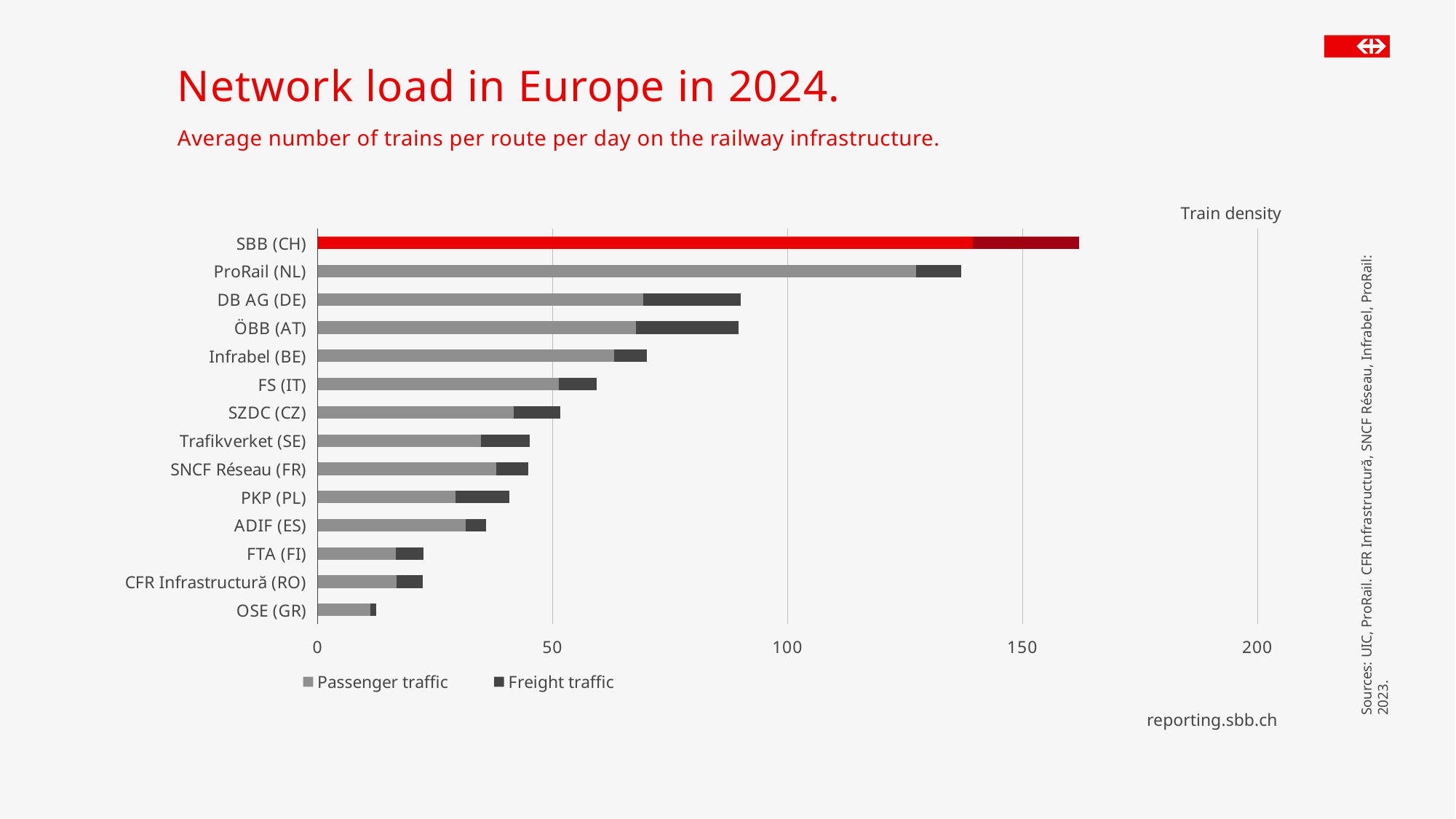
Which has the higher total train density, Infrabel (BE) or FS (IT)? Infrabel (BE) Is the total train density for DB AG (DE) greater or less than 100? less Which has the higher total train density, SBB (CH) or ProRail (NL)? SBB (CH) Which infrastructure manager has the highest train density? SBB (CH) How many series does the legend list? 2 How many railway infrastructure managers are listed on the chart? 14 Is the total train density for ProRail (NL) greater or less than 150? less Which infrastructure manager has the lowest train density? OSE (GR) What kind of chart is shown on the slide? bar chart Is the total train density for SBB (CH) greater or less than 150? greater What are the two series named in the legend? Passenger traffic and Freight traffic